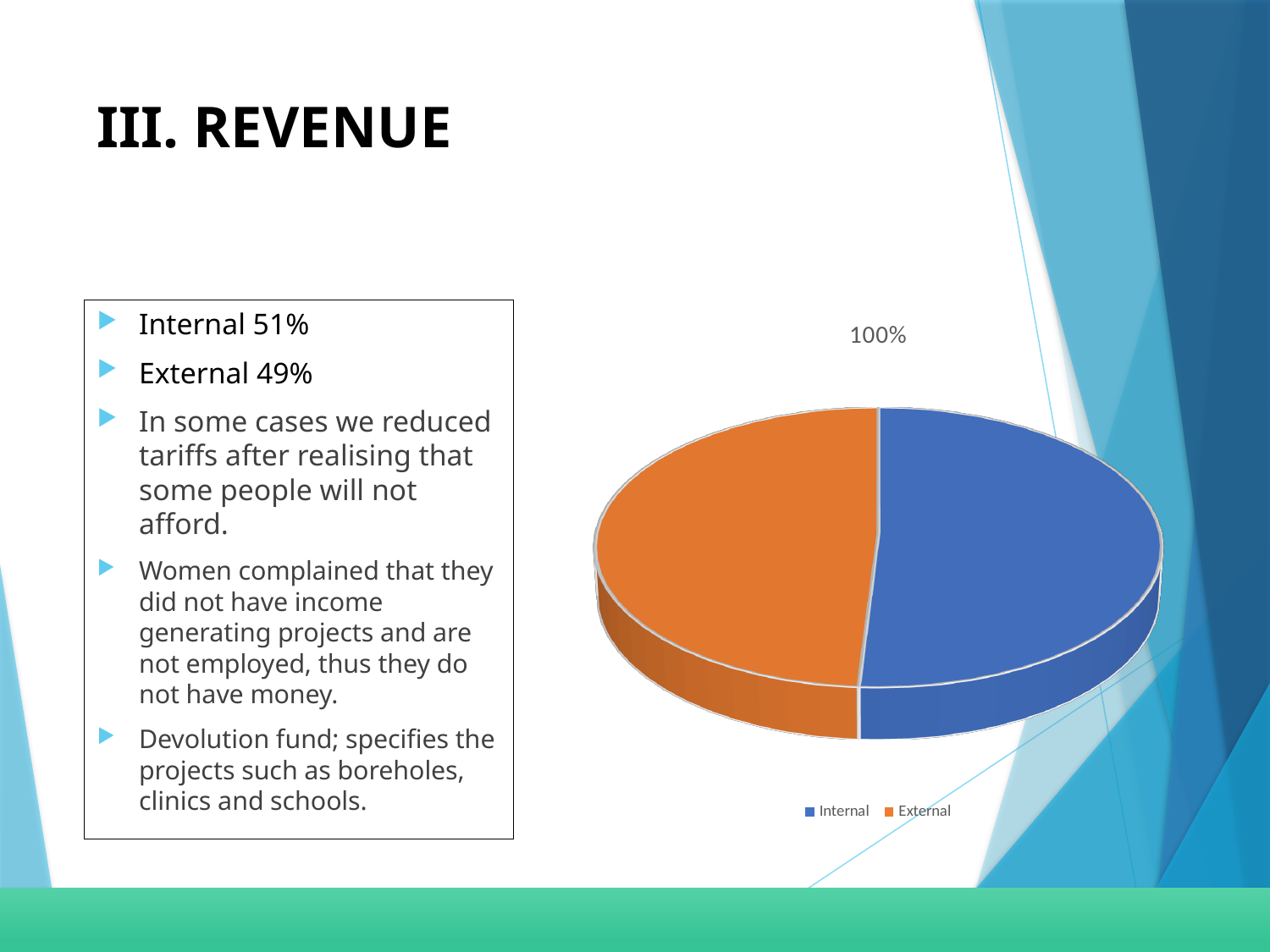
What share of revenue does the External slice represent? 49% What kind of chart is shown on the slide? pie chart What share of revenue does the Internal slice represent? 51% What is the difference between the Internal and External shares? 2% What is the title shown above the pie chart? 100% How many entries does the pie chart's legend list? 2 Which slice is larger, Internal or External? Internal What are the two legend entries of the pie chart? Internal and External How many slices does the pie chart have? 2